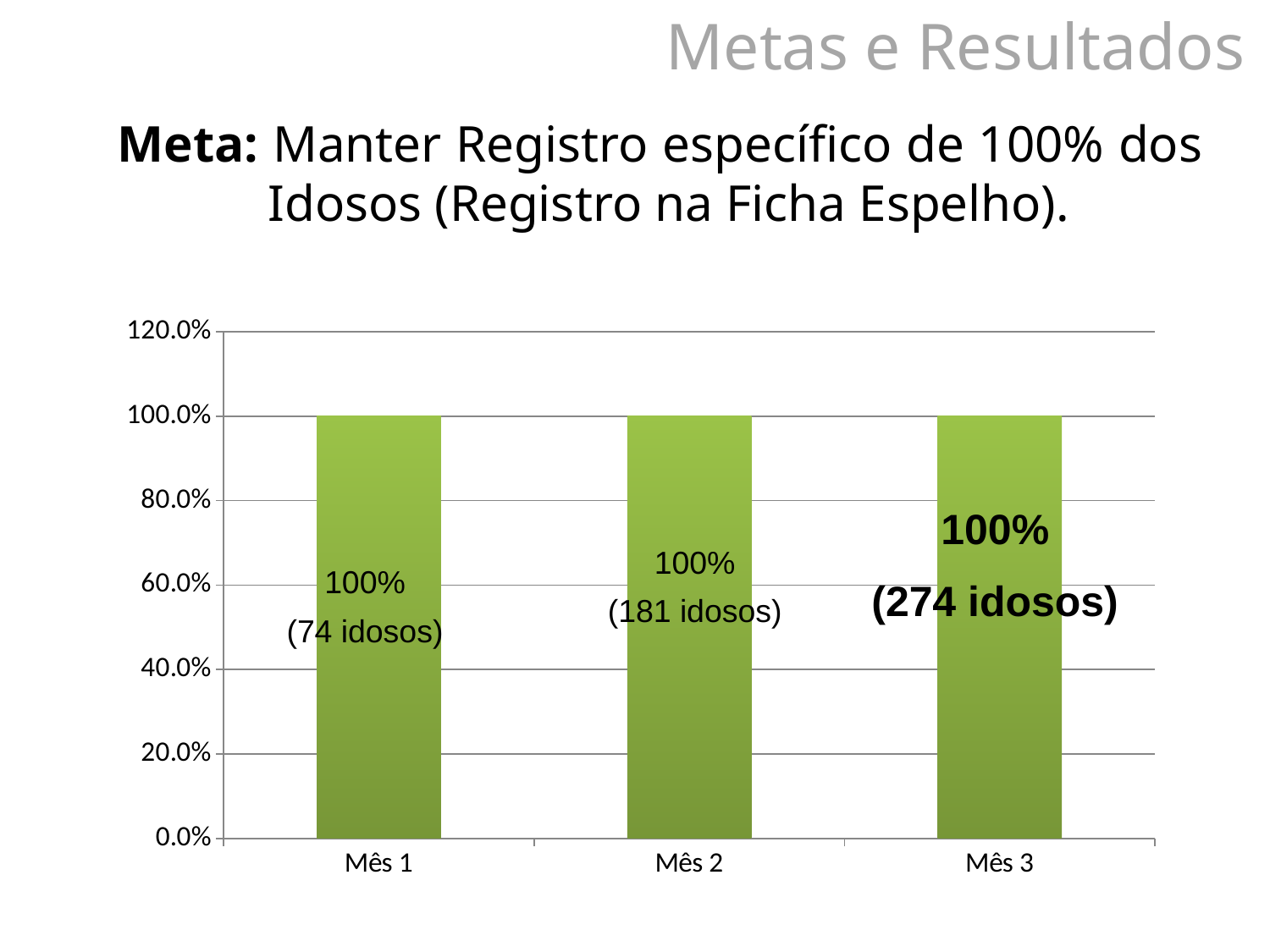
How many categories (months) are shown on the x axis? 3 What kind of chart is shown on the slide? Bar chart How many idosos are indicated in the data label for Mês 1? 74 idosos What is the highest value shown on the y axis? 120.0% Is the value for Mês 2 greater or less than 80.0%? greater What is the difference in the number of idosos between Mês 2 and Mês 1? 107 How many idosos are indicated in the data label for Mês 3? 274 idosos Do the percentage values rise, fall, or stay the same from Mês 1 to Mês 3? Stay the same Which month has more idosos in its data label, Mês 1 or Mês 3? Mês 3 What is the difference in the number of idosos between Mês 3 and Mês 1? 200 How many idosos are indicated in the data label for Mês 2? 181 idosos What percentage is shown for Mês 1? 100%